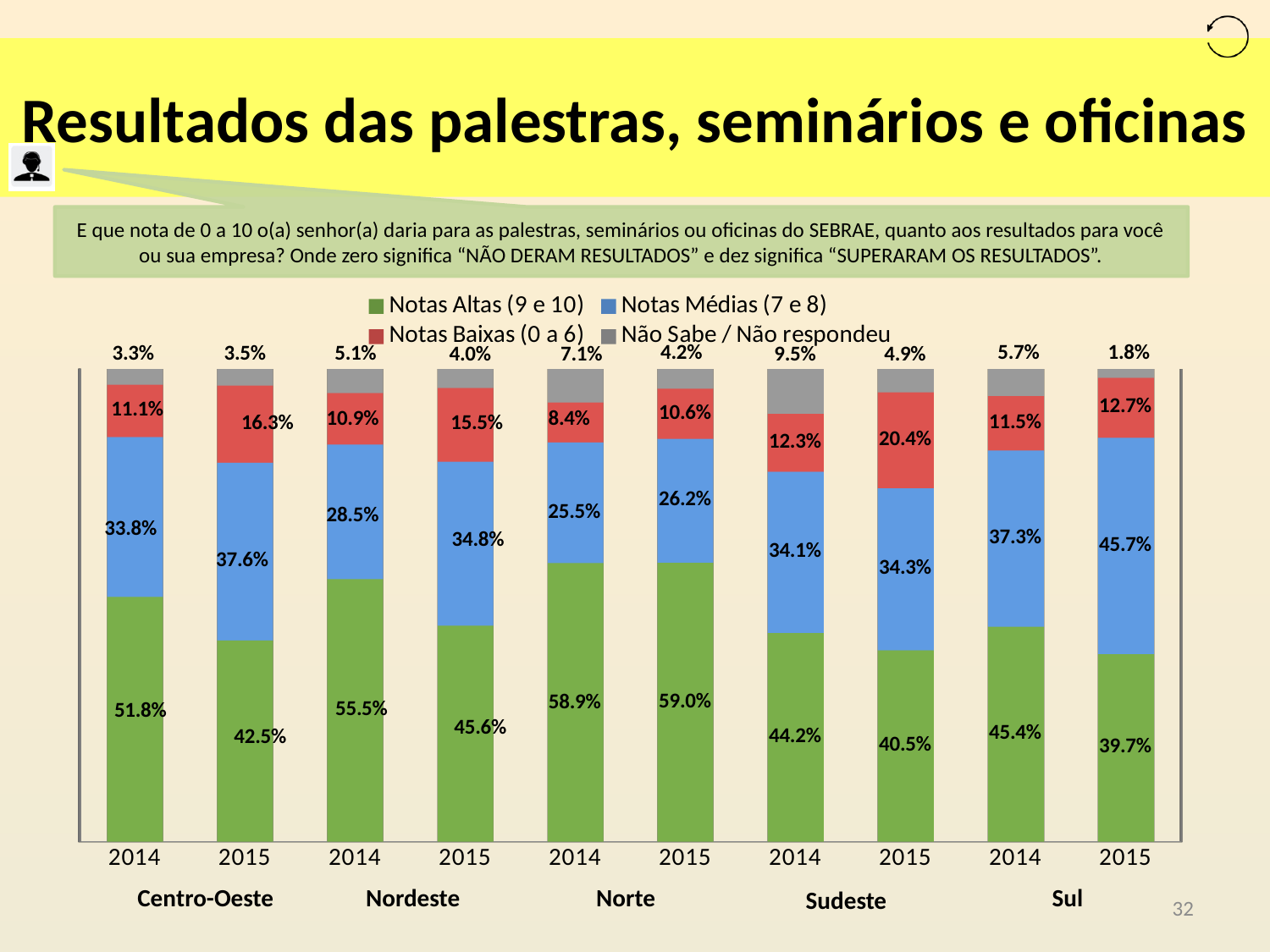
For Sul in 2015, which is larger: Notas Altas (9 e 10) or Notas Médias (7 e 8)? Notas Médias (7 e 8) What is the difference in Notas Altas (9 e 10) for Centro-Oeste between 2014 and 2015? 9.3 percentage points What is the value of Notas Baixas (0 a 6) for Sudeste in 2015? 20.4% What is the value of Notas Altas (9 e 10) for Centro-Oeste in 2014? 51.8% What is the value of Não Sabe / Não respondeu for Sul in 2015? 1.8% Which bar has the highest value for Não Sabe / Não respondeu? Sudeste 2014 Did the Notas Altas (9 e 10) value for Nordeste rise or fall from 2014 to 2015? Fall Which bar has the lowest value for Não Sabe / Não respondeu? Sul 2015 Which bar has the highest value for Notas Baixas (0 a 6)? Sudeste 2015 How many series does the legend list? 4 How many bars are shown in the chart? 10 What kind of chart is shown on the slide? Stacked bar chart